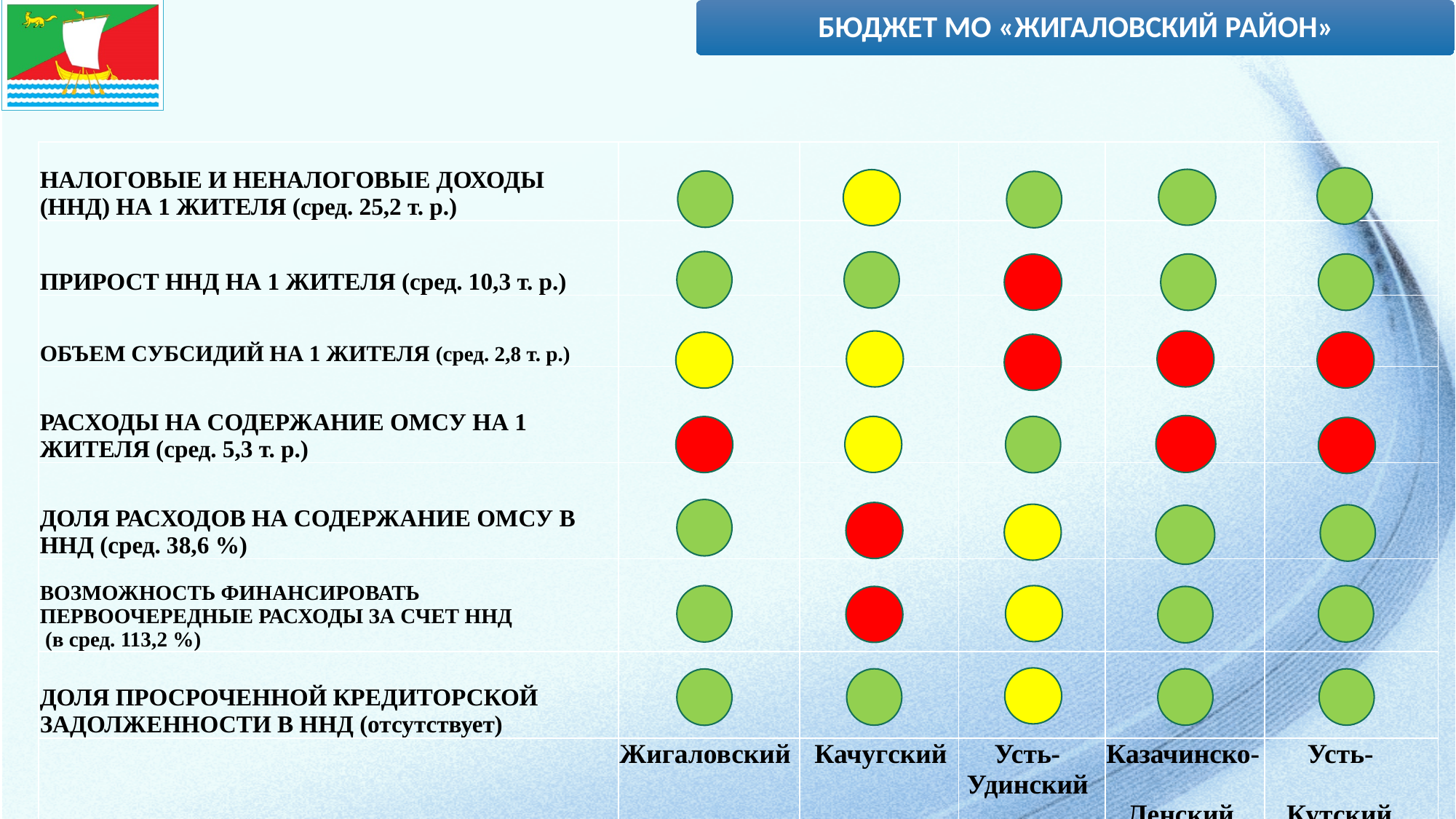
What colour is the indicator for Качугский in the row «НАЛОГОВЫЕ И НЕНАЛОГОВЫЕ ДОХОДЫ (ННД) НА 1 ЖИТЕЛЯ»? yellow How many red indicators are there in the row «ОБЪЕМ СУБСИДИЙ НА 1 ЖИТЕЛЯ»? 3 How many indicators (rows) are shown on the slide? 7 Which district has the fewest red indicators? Жигаловский What colour is the indicator for Усть-Удинский in the row «ПРИРОСТ ННД НА 1 ЖИТЕЛЯ»? red What is the title shown in the header of the slide? БЮДЖЕТ МО «ЖИГАЛОВСКИЙ РАЙОН» What kind of chart is shown on the slide? a matrix of coloured indicator circles (traffic-light table) What colour is the indicator for Жигаловский in the row «РАСХОДЫ НА СОДЕРЖАНИЕ ОМСУ НА 1 ЖИТЕЛЯ»? red How many municipal districts (columns) are compared on the slide? 5 What colour is the indicator for Усть-Кутский in the row «ДОЛЯ ПРОСРОЧЕННОЙ КРЕДИТОРСКОЙ ЗАДОЛЖЕННОСТИ В ННД»? green What average value is given for «НАЛОГОВЫЕ И НЕНАЛОГОВЫЕ ДОХОДЫ (ННД) НА 1 ЖИТЕЛЯ»? 25,2 т. р.